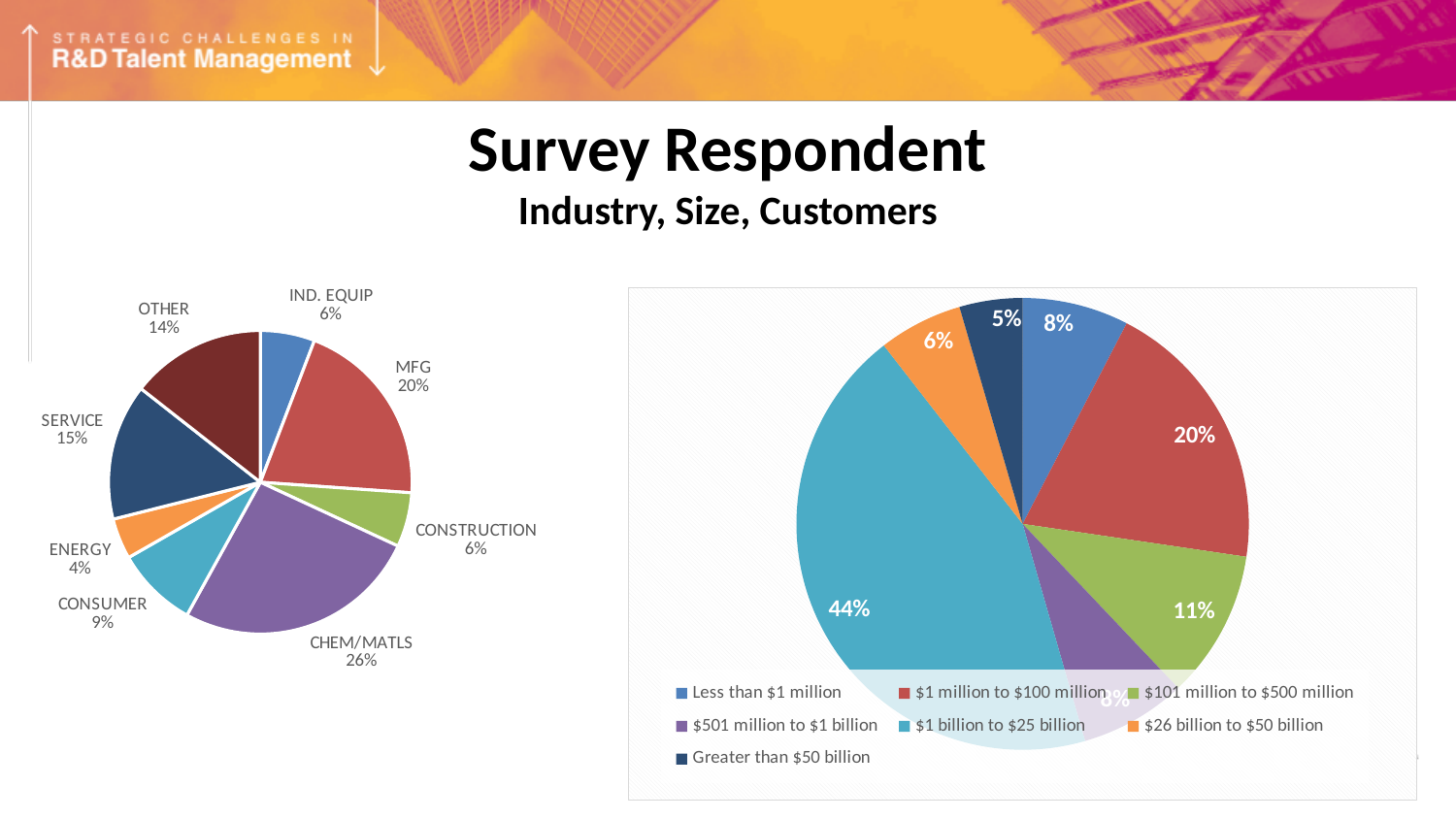
In the right pie chart, what share of respondents is in the $1 million to $100 million category? 20% How many categories does the legend of the right pie chart list? 7 How many industry categories are shown in the left pie chart? 8 In the left pie chart, what share of respondents is SERVICE? 15% In the left pie chart, which industry has the smallest share? ENERGY In the left pie chart, which industry has the largest share? CHEM/MATLS In the left pie chart, which is larger, OTHER or SERVICE? SERVICE What type of chart is used on the left side of the slide? Pie chart In the right pie chart, which size category has the largest share? $1 billion to $25 billion In the left pie chart, what is the difference between the MFG share and the CONSUMER share? 11% In the right pie chart, what share of respondents is in the $1 billion to $25 billion category? 44% In the left pie chart, what share of respondents is CHEM/MATLS? 26%